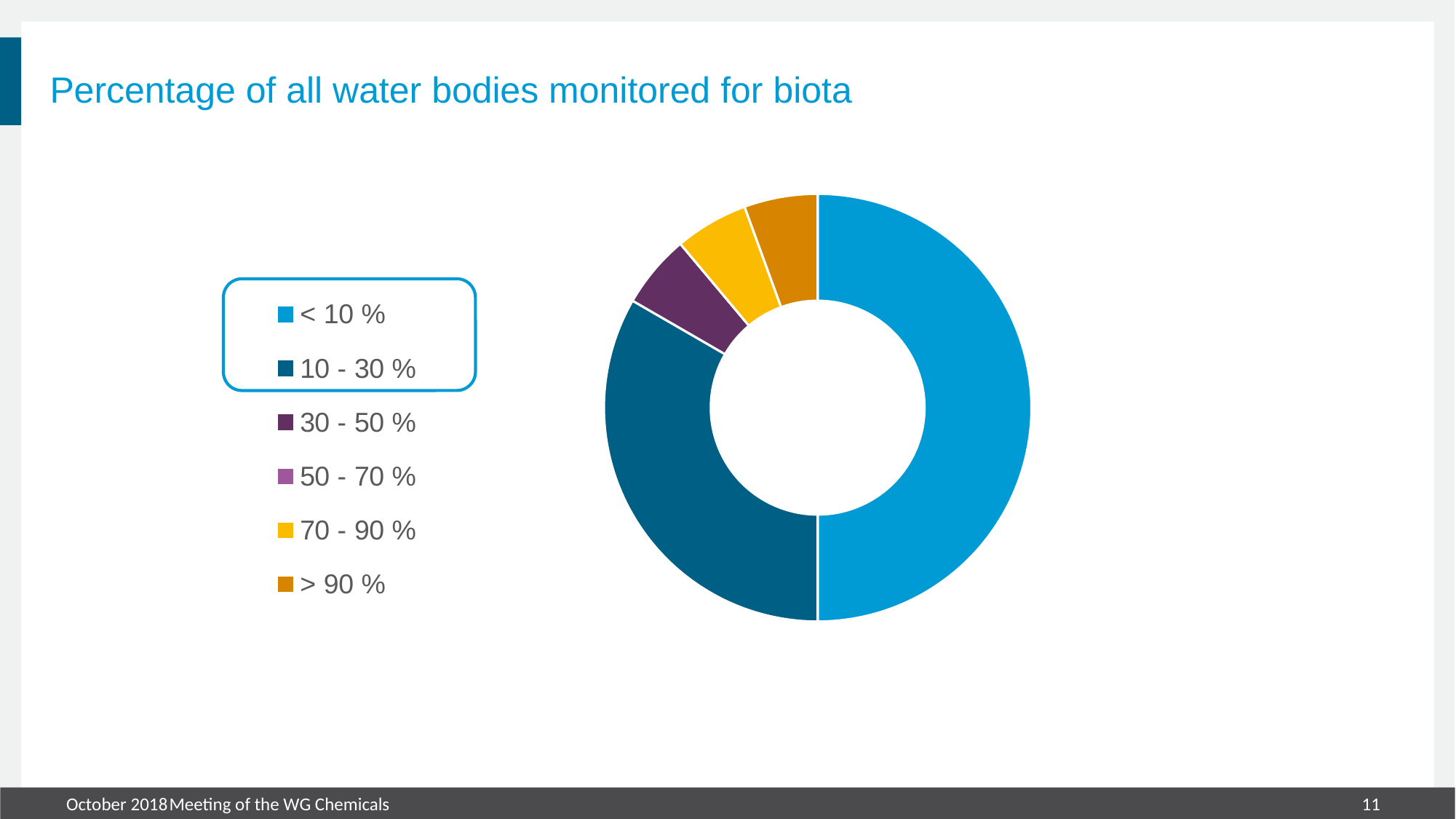
What is the title of the chart? Percentage of all water bodies monitored for biota What kind of chart is shown on the slide? doughnut chart Which category has the largest slice of the doughnut chart? < 10 % How many categories does the legend list? 6 Which slice is larger, < 10 % or 10 - 30 %? < 10 % Which two legend entries are enclosed in a highlighted box? < 10 % and 10 - 30 % Which slice is larger, 10 - 30 % or 30 - 50 %? 10 - 30 % Which slice is larger, < 10 % or > 90 %? < 10 %